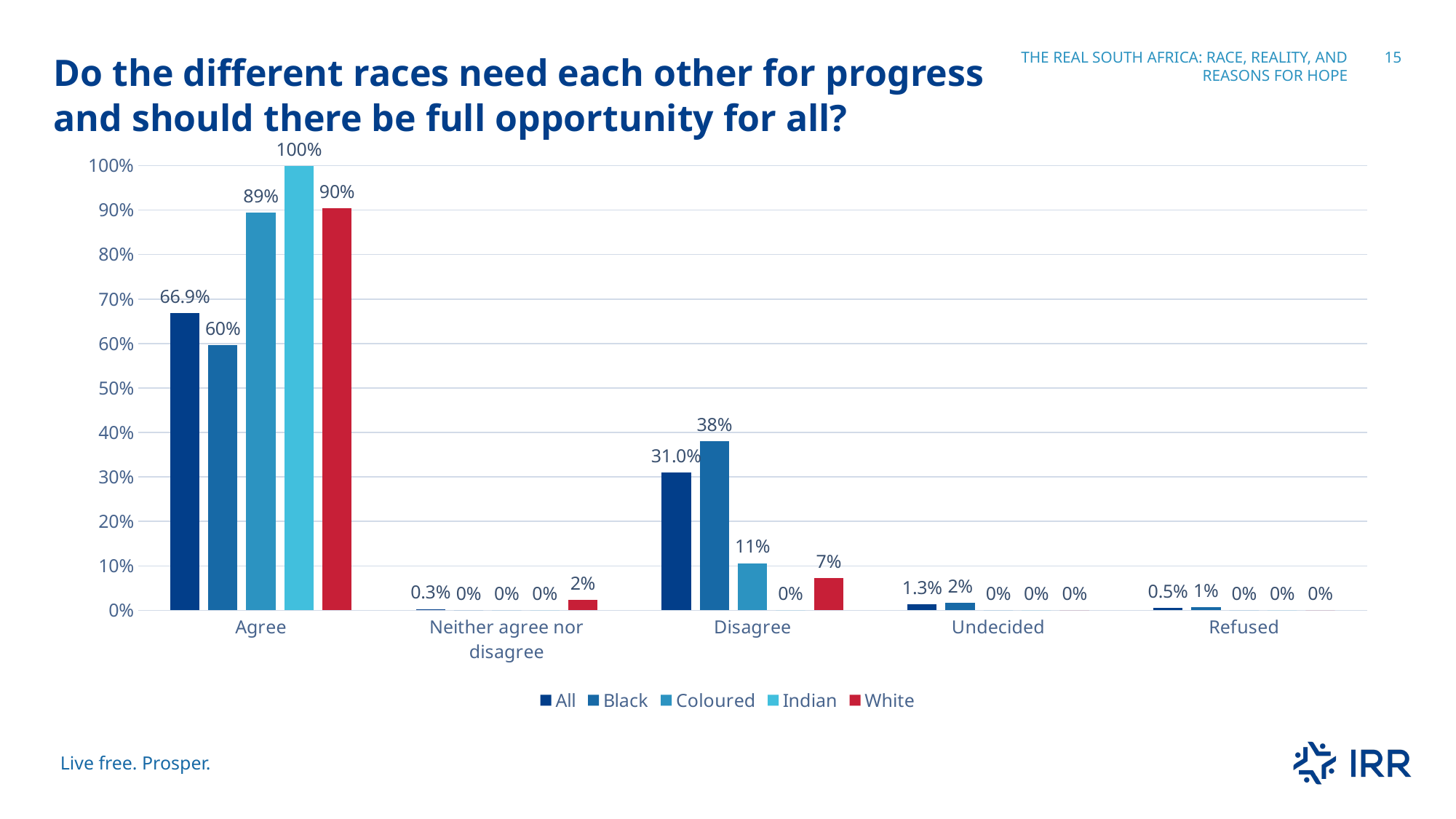
Which series has the lowest value in the Agree category? Black Which is larger in the Agree category, the value for Coloured or the value for White? White What is the difference between the Black and Coloured values in the Disagree category? 27% Which series is shown in red in the legend? White What is the value for White in the Neither agree nor disagree category? 2% How many series does the legend list? 5 What kind of chart is shown on the slide? bar chart What is the value for Indian in the Agree category? 100% Is the value for Black in the Agree category greater or less than 70%? less How many categories are shown on the x axis? 5 Which series has the highest value in the Agree category? Indian What is the value for All in the Disagree category? 31.0%